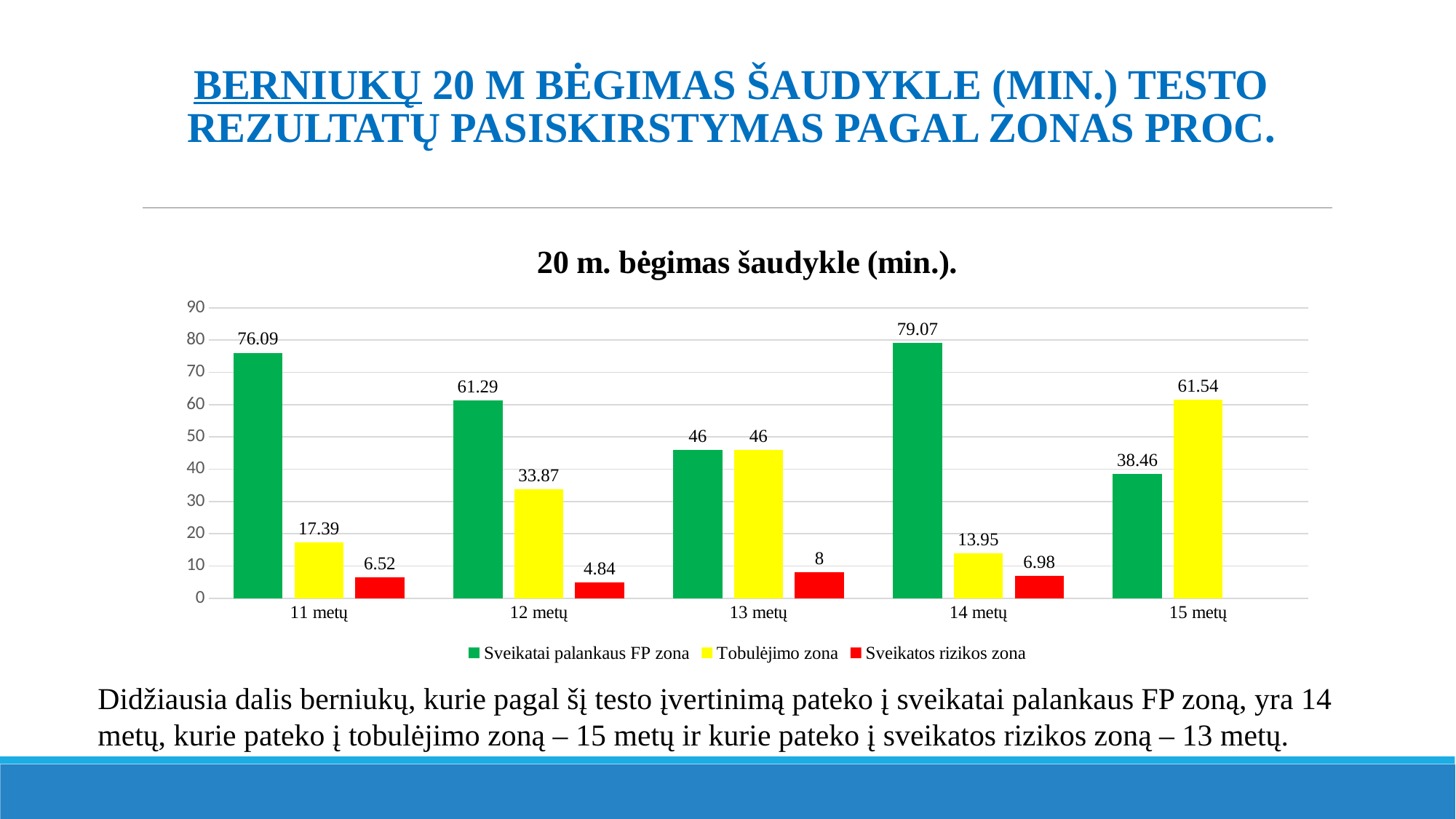
Which age group has the lowest value for Sveikatos rizikos zona? 12 metų How many series does the legend list? 3 Which is larger at 15 metų: Sveikatai palankaus FP zona or Tobulėjimo zona? Tobulėjimo zona Which age group has the highest value for Sveikatai palankaus FP zona? 14 metų What is the value for Sveikatos rizikos zona at 12 metų? 4.84 What is the value for Sveikatai palankaus FP zona at 14 metų? 79.07 What is the title of the chart? 20 m. bėgimas šaudykle (min.). What kind of chart is shown on the slide? Bar chart How many age groups are shown on the x axis? 5 What is the value for Tobulėjimo zona at 15 metų? 61.54 Is the value for Tobulėjimo zona at 12 metų greater or less than 30? greater What is the difference between the Sveikatai palankaus FP zona values at 11 metų and 12 metų? 14.80